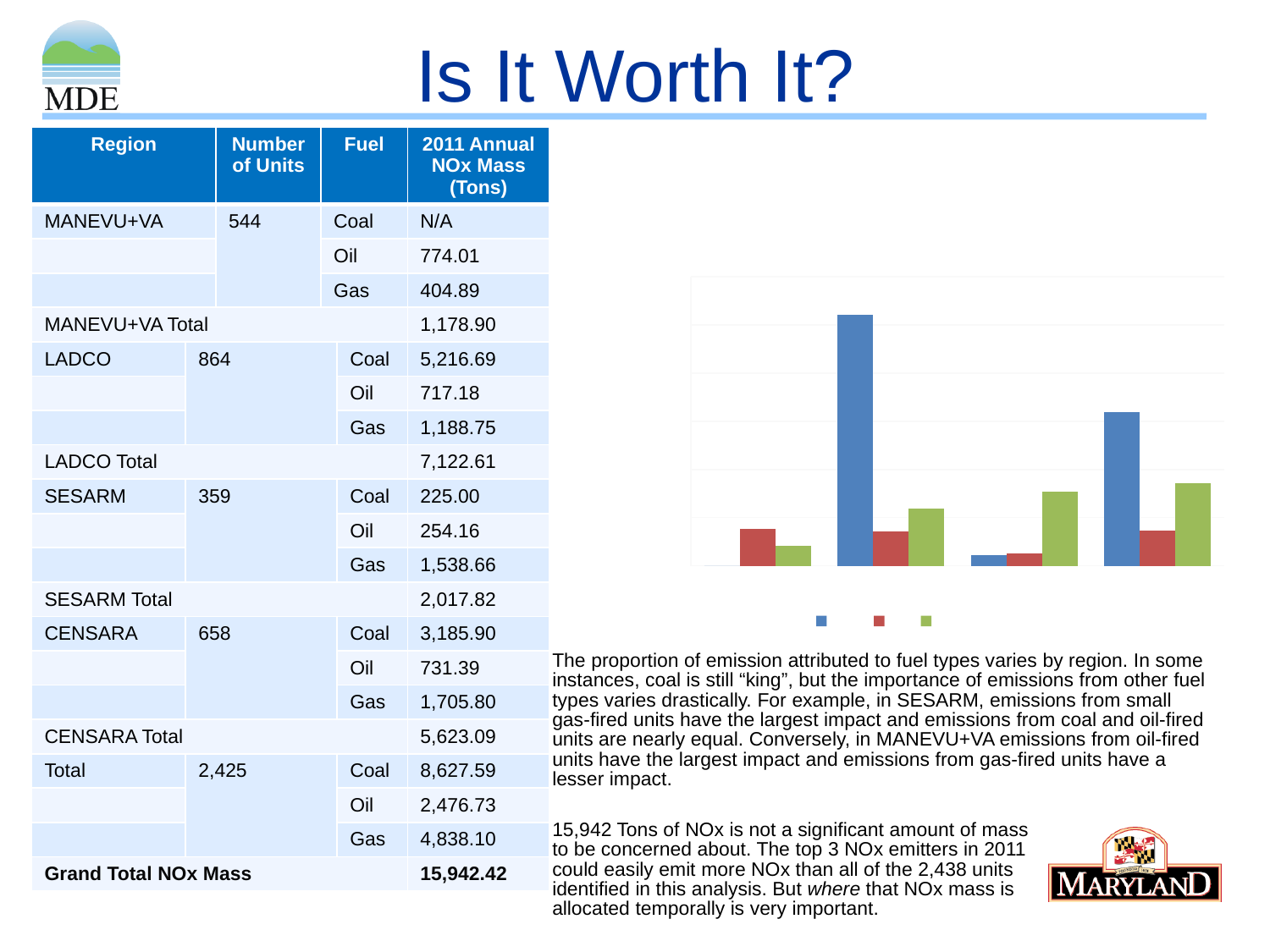
In the chart on the right, in the first group from the left, is the red bar taller or shorter than the green bar? taller In the chart on the right, in the third group from the left, which colour bar is the tallest? green What colours are the three series in the chart on the right? blue, red and green In the chart on the right, which group of bars (counting from the left) contains the tallest bar? the second group How many series does the legend of the chart on the right list? 3 In the chart on the right, in the second group from the left, which colour bar is the tallest? blue How many groups of bars does the chart on the right show? 4 What kind of chart is shown on the right side of the slide? bar chart